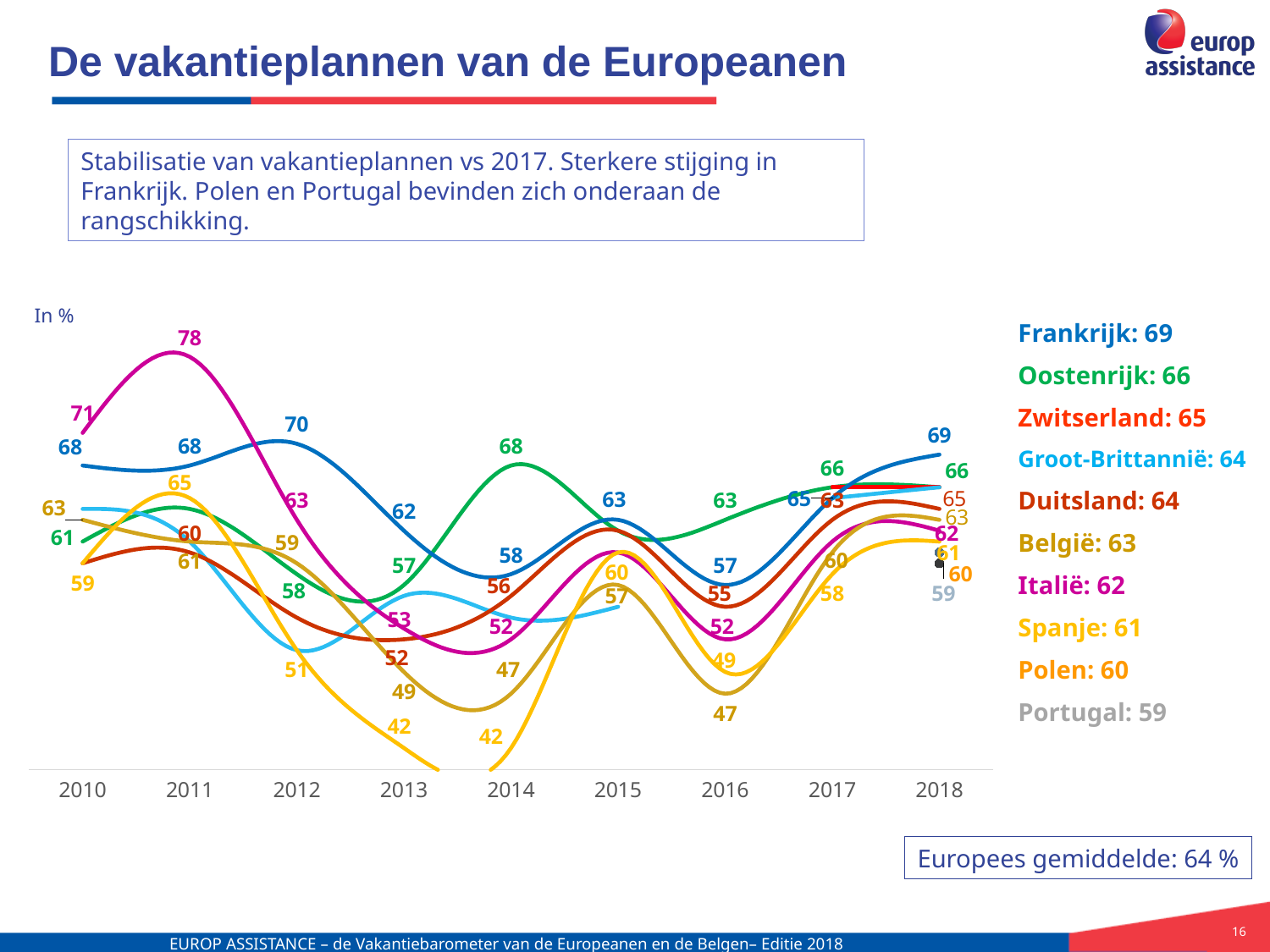
What is the value for Portugal in 2018? 59 Which country has the lowest value in 2018? Portugal What is the value for Frankrijk in 2018? 69 What kind of chart is shown on the slide? line chart Which country has the highest value in 2018? Frankrijk How many countries are listed in the legend to the right of the chart? 10 How many years are shown along the x axis of the chart? 9 What is the highest value labelled anywhere on the chart, and in which year does it occur? 78, in 2011 What is the value for Groot-Brittannië in 2018? 64 What is the European average (Europees gemiddelde) stated on the slide? 64 % In 2018, which is larger: the value for Oostenrijk or the value for Polen? Oostenrijk What is the difference between the 2018 values of Frankrijk and Portugal? 10